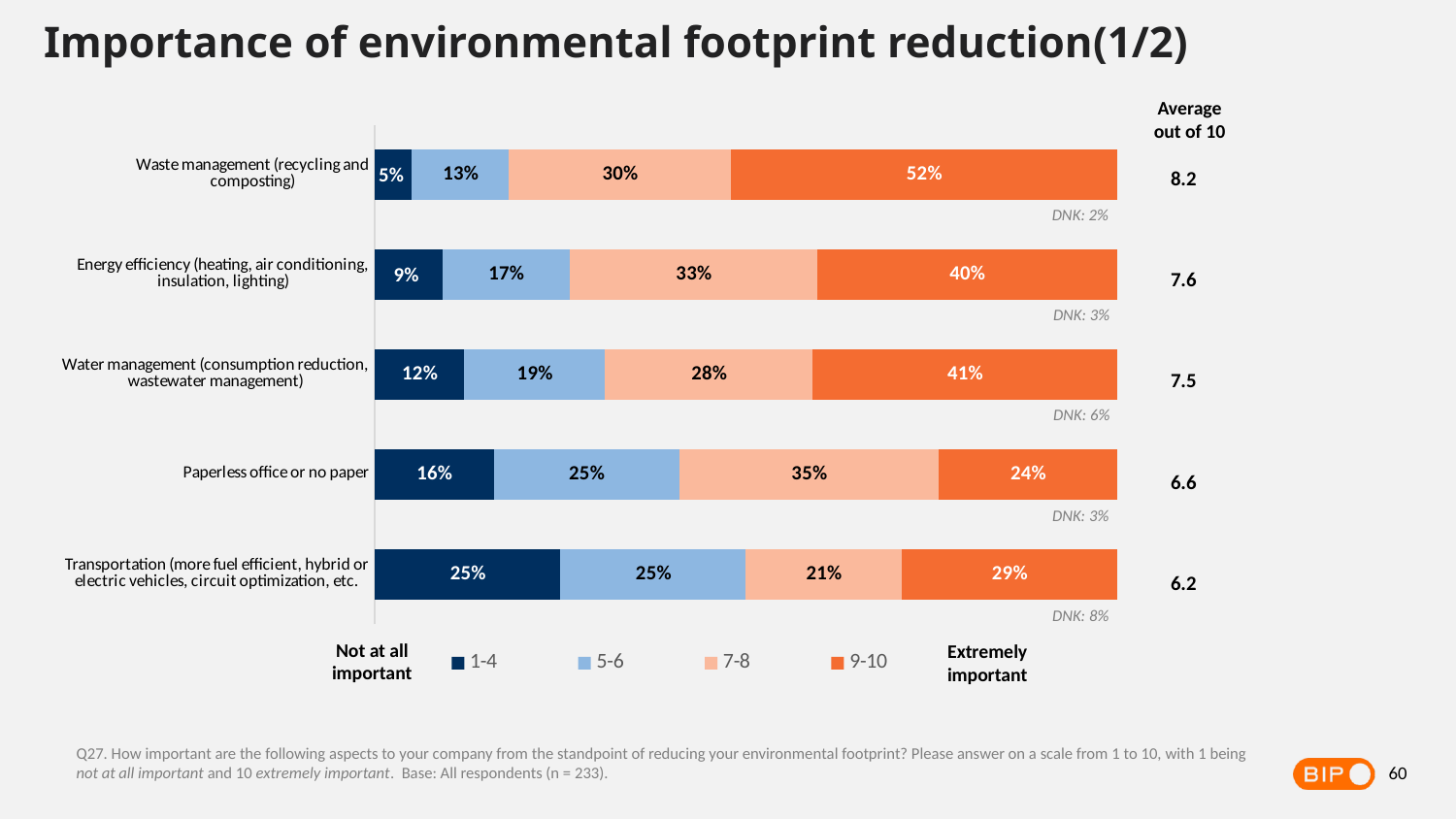
How many aspects (categories) are shown in the chart? 5 What is the DNK percentage for Transportation? 8% What percentage of respondents rated Transportation (more fuel efficient, hybrid or electric vehicles, circuit optimization, etc.) as 1-4? 25% Which has a larger 5-6 share: Water management or Energy efficiency? Water management What is the difference in percentage points between the 9-10 share for Waste management and the 9-10 share for Energy efficiency? 12 percentage points What percentage of respondents rated Waste management (recycling and composting) as 9-10? 52% What is the average score out of 10 for Water management (consumption reduction, wastewater management)? 7.5 What kind of chart is shown on the slide? Stacked bar chart Which aspect has the highest share of 9-10 ratings? Waste management (recycling and composting) How many rating groups does the legend list? 4 What is the title of the slide? Importance of environmental footprint reduction(1/2) Which aspect has the lowest share of 9-10 ratings? Paperless office or no paper